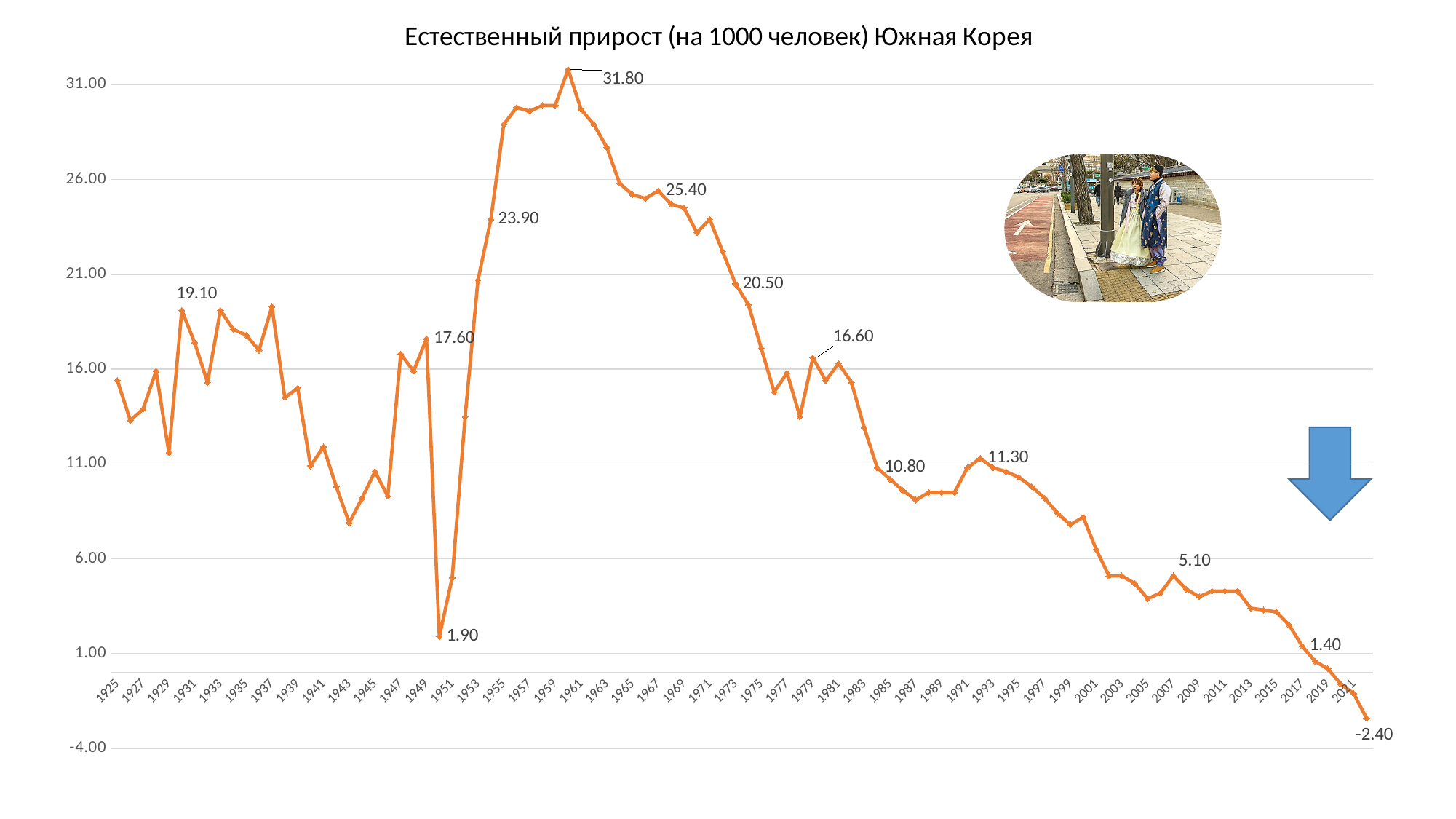
Which labeled value is larger, 23.90 or 25.40? 25.40 What is the difference between the labeled values 19.10 and 17.60? 1.50 What is the difference between the highest labeled value (31.80) and the lowest labeled value (-2.40)? 34.20 What is the highest value labeled on the chart? 31.80 Does the line rise or fall from 1993 to the end of the x axis? fall Is the value for 1925 greater or less than 11.00? greater What kind of chart is shown on the slide? line chart Is the value for 2001 greater or less than 11.00? less What is the value labeled at the sharp dip of the line around 1950? 1.90 What is the value labeled at the last point of the line, at the right end of the chart? -2.40 What is the title of the chart? Естественный прирост (на 1000 человек) Южная Корея What is the lowest value labeled on the chart? -2.40